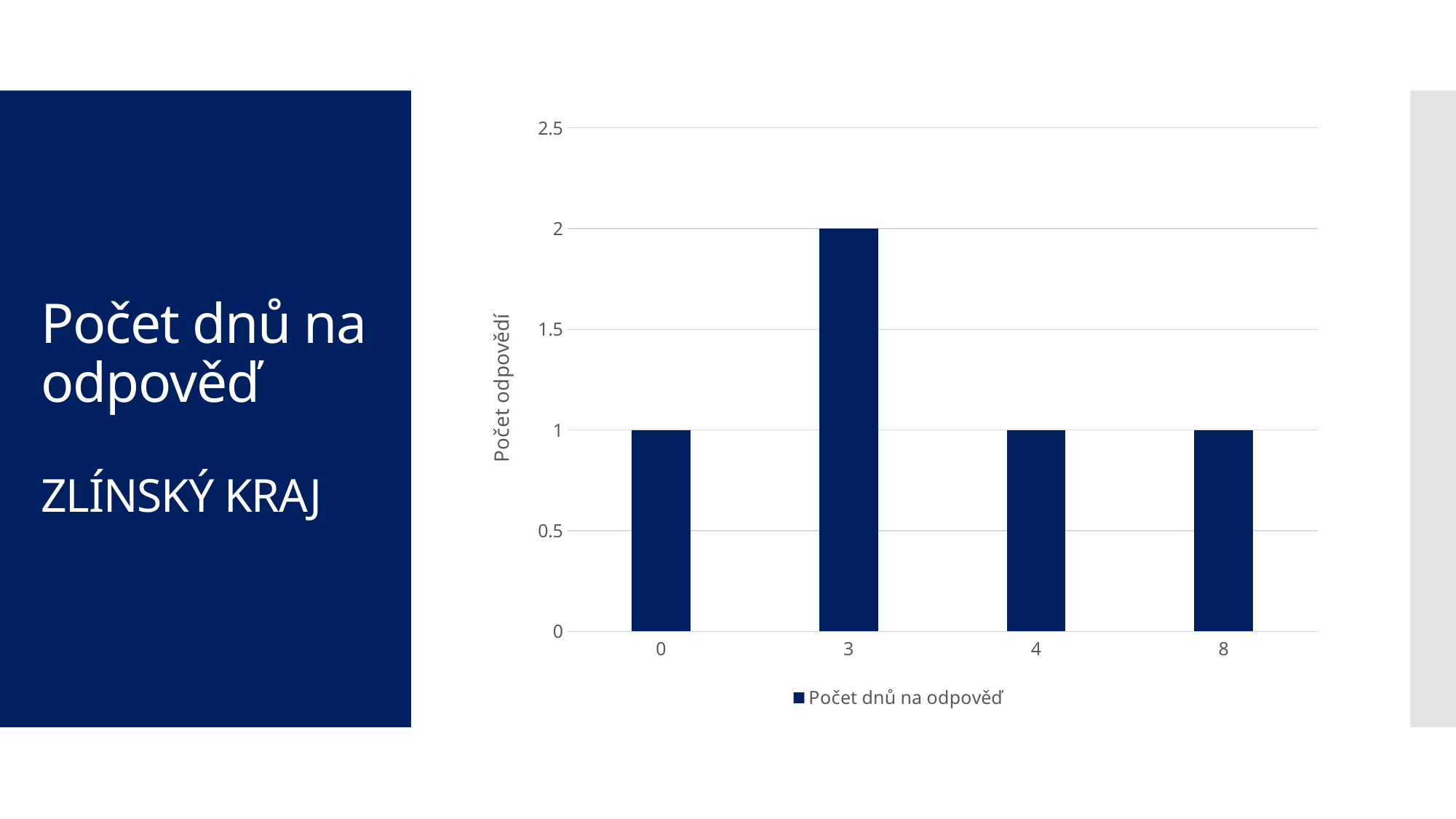
Which has the larger value, category 3 or category 8? 3 What kind of chart is shown on the slide? bar chart What is the label of the vertical axis of the chart? Počet odpovědí What is the value (Počet odpovědí) for category 0? 1 Is the value for category 3 greater or less than 1.5? greater What is the series name shown in the chart legend? Počet dnů na odpověď How many categories are shown on the x axis of the chart? 4 What is the value (Počet odpovědí) for category 3? 2 What is the difference between the values for category 3 and category 4? 1 Which category has the highest value in the chart? 3 How many series does the chart legend list? 1 What is the value (Počet odpovědí) for category 8? 1